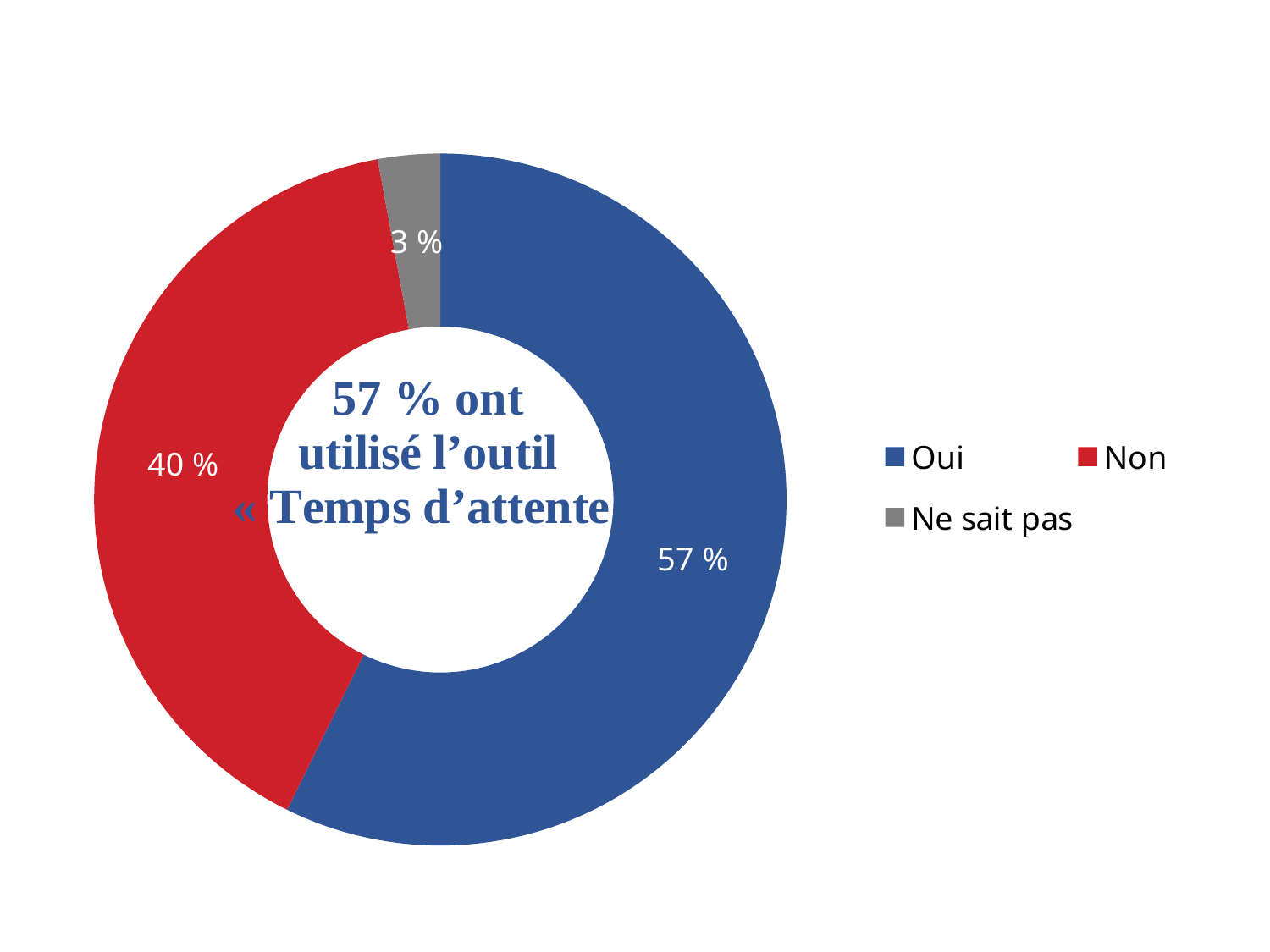
How many categories does the chart show? 3 What percentage of the doughnut chart is labelled "Oui"? 57 % What percentage of the doughnut chart is labelled "Non"? 40 % What is the difference in percentage points between the "Oui" and "Non" shares? 17 Which is larger, the share for "Non" or the share for "Ne sait pas"? Non What percentage of the doughnut chart is labelled "Ne sait pas"? 3 % What kind of chart is shown on the slide? Doughnut (pie) chart Which category has the smallest share of the chart? Ne sait pas What colour is the "Non" segment of the chart? Red How many entries does the legend list? 3 Which category has the largest share of the chart? Oui What text is written in the centre of the doughnut chart? 57 % ont utilisé l’outil « Temps d’attente